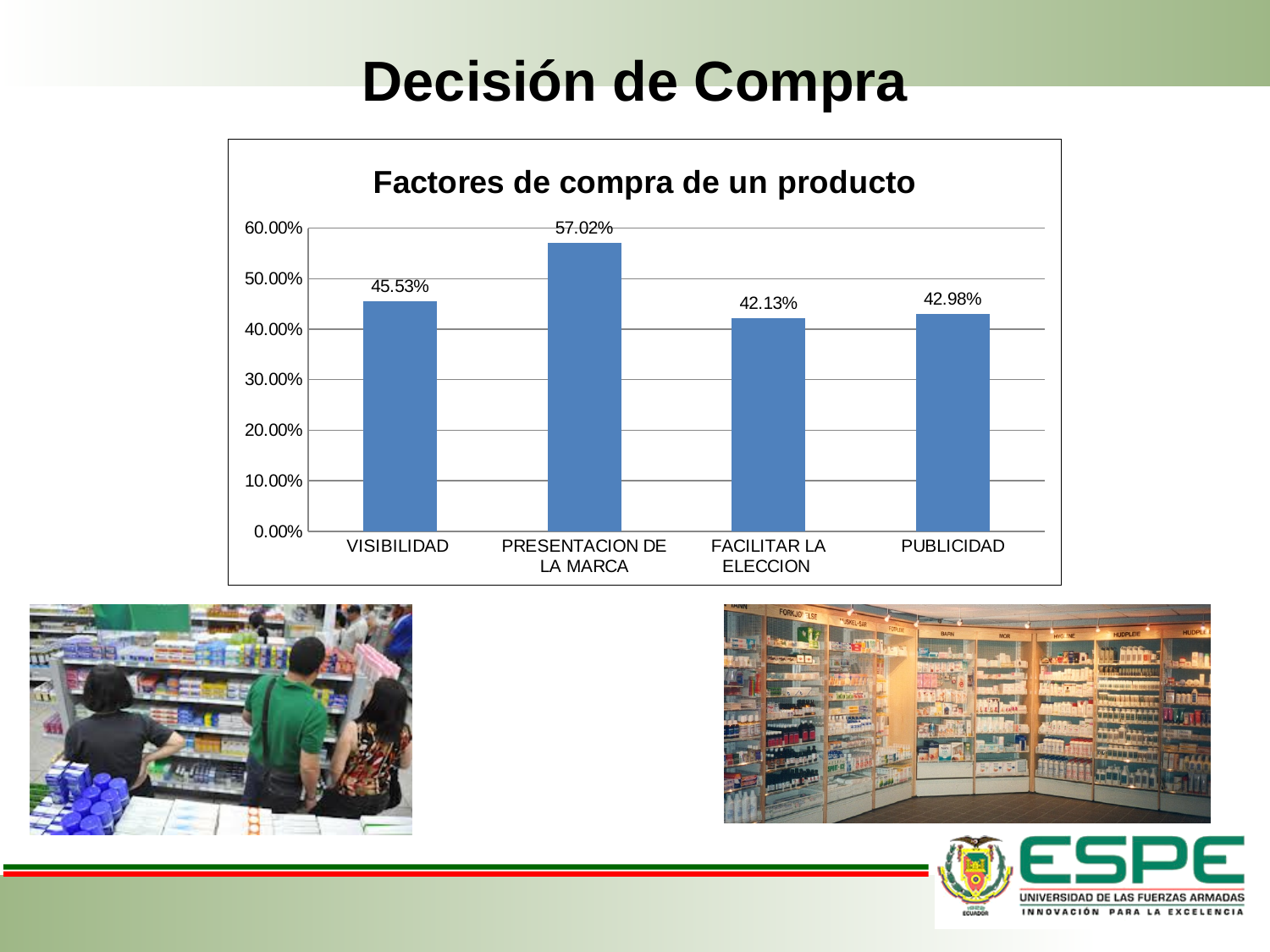
Which factor has the lowest value? FACILITAR LA ELECCION Is the value for PRESENTACION DE LA MARCA greater or less than 50.00%? greater What is the value for PRESENTACION DE LA MARCA? 57.02% Which is larger, the value for VISIBILIDAD or the value for PUBLICIDAD? VISIBILIDAD How many factors are shown in the chart? 4 What is the title of the chart? Factores de compra de un producto What is the value for PUBLICIDAD? 42.98% What is the difference between the values for PRESENTACION DE LA MARCA and VISIBILIDAD? 11.49% Which factor has the highest value? PRESENTACION DE LA MARCA What is the value for FACILITAR LA ELECCION? 42.13% What is the value for VISIBILIDAD? 45.53% What kind of chart is shown on the slide? bar chart